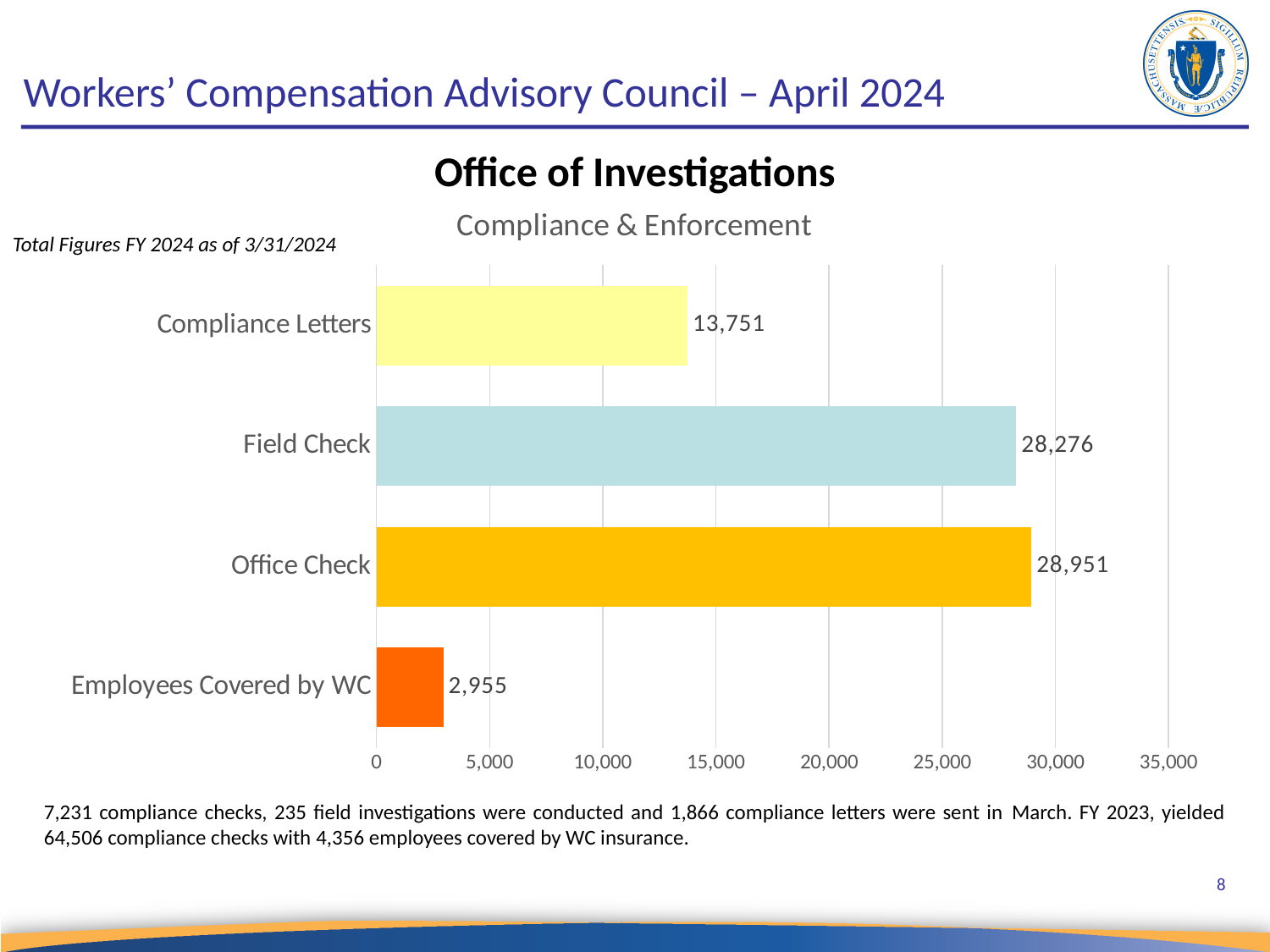
What is the value for Office Check? 28,951 What is the value for Compliance Letters? 13,751 What is the difference between the Office Check and Field Check values? 675 Which is larger, the value for Compliance Letters or the value for Field Check? Field Check How many categories are shown in the chart? 4 Which category has the highest value? Office Check Which category has the lowest value? Employees Covered by WC What is the value for Employees Covered by WC? 2,955 What kind of chart is shown on the slide? Bar chart What is the value for Field Check? 28,276 What is the difference between the Compliance Letters and Employees Covered by WC values? 10,796 What is the title of the chart? Compliance & Enforcement